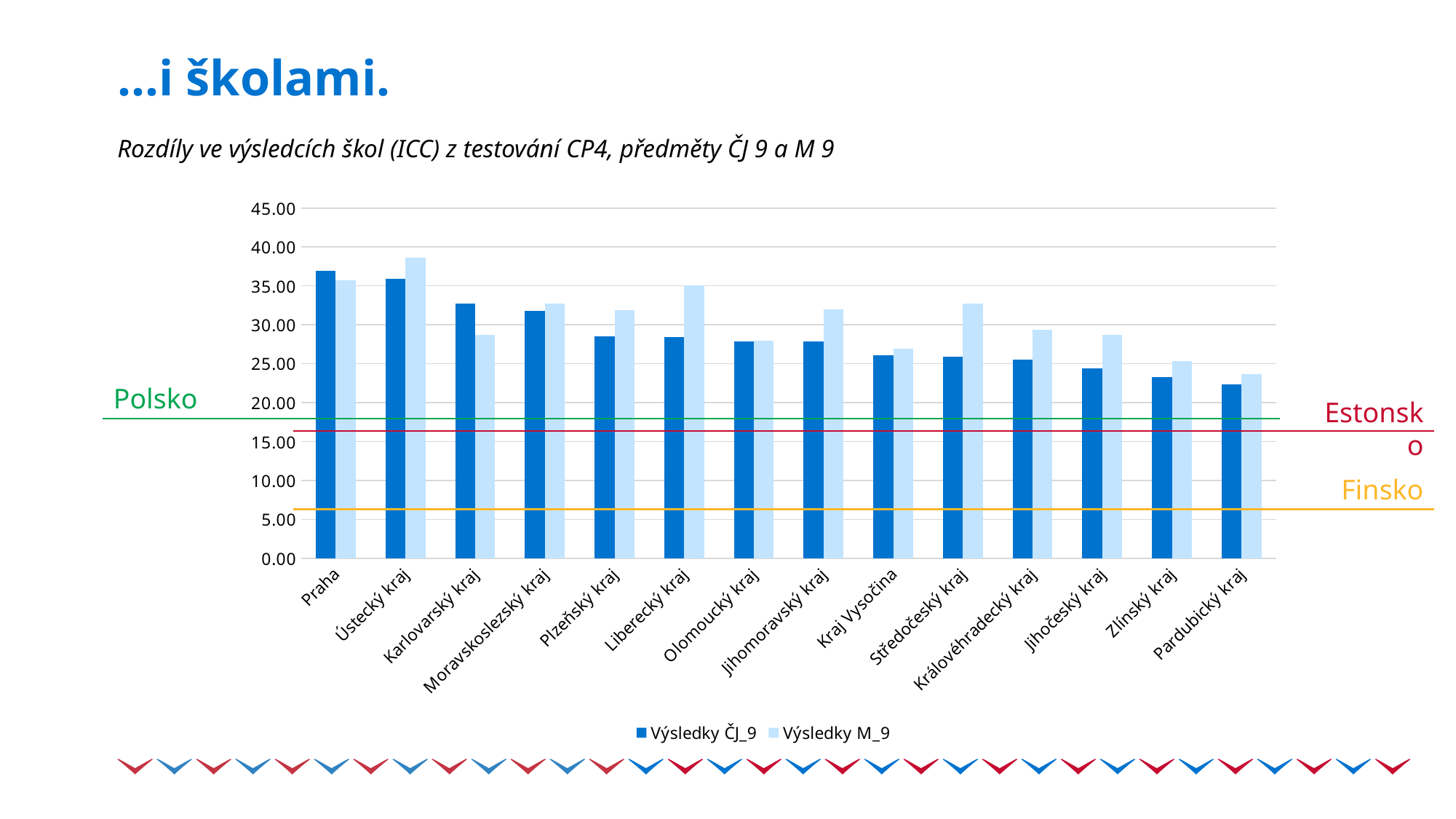
Is the Výsledky ČJ_9 value for Praha greater or less than 35.00? greater Which region has the highest value for Výsledky M_9? Ústecký kraj How many regions (categories) are shown on the x axis? 14 Is the Výsledky ČJ_9 value for Pardubický kraj greater or less than 25.00? less Which region has the lowest value for Výsledky ČJ_9? Pardubický kraj Do the Výsledky ČJ_9 values rise or fall from left to right along the x axis? fall For Karlovarský kraj, which is larger: Výsledky ČJ_9 or Výsledky M_9? Výsledky ČJ_9 Is the Výsledky M_9 value for Liberecký kraj greater or less than 30.00? greater Which three countries are labelled on the horizontal reference lines in the chart? Polsko, Estonsko, Finsko Which region has the highest value for Výsledky ČJ_9? Praha What kind of chart is shown on the slide? bar chart How many series does the legend list? 2